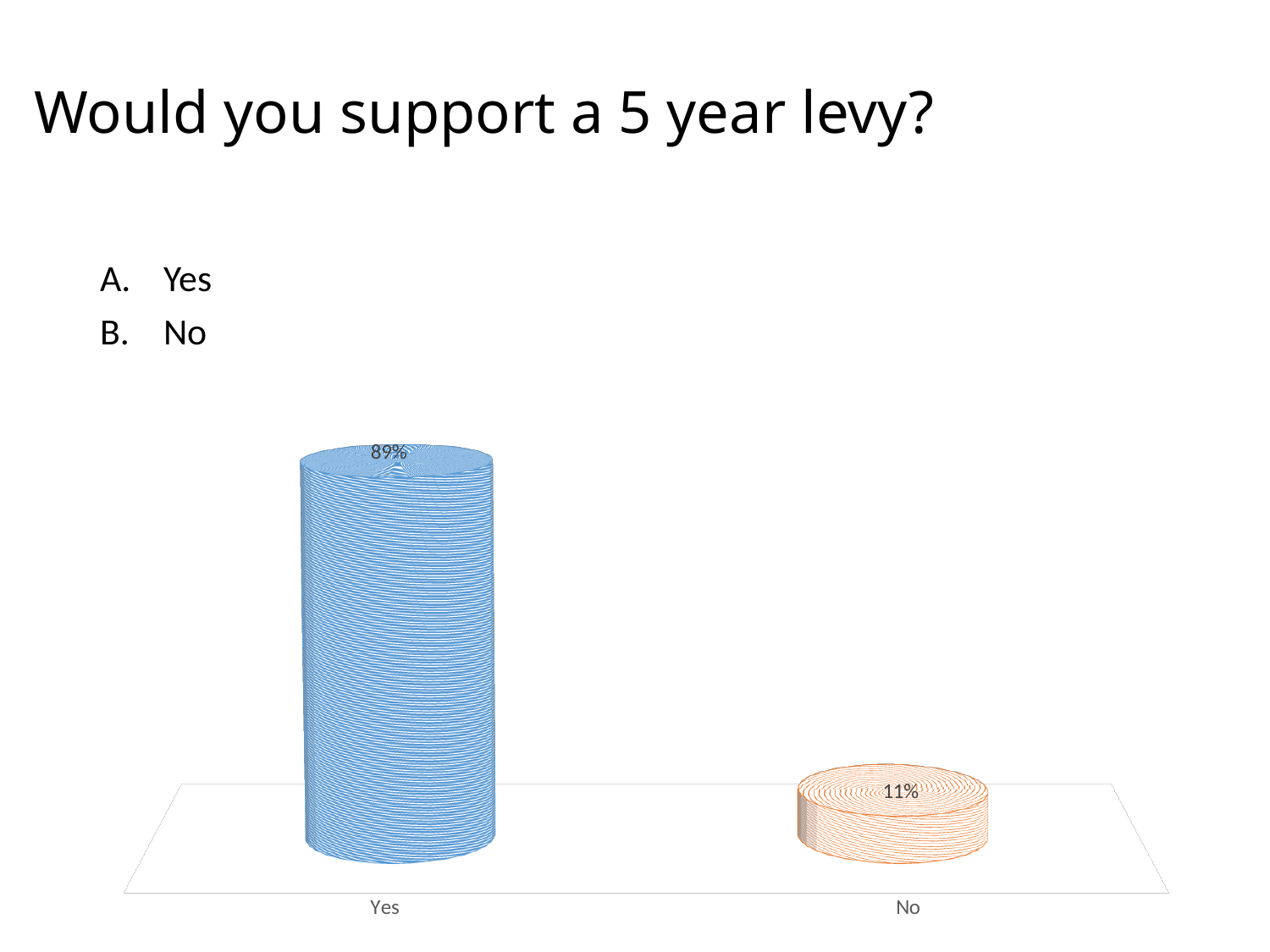
Which category has the lowest value? No Which is larger, the value for Yes or the value for No? Yes How many categories are shown on the x axis? 2 Which category has the highest value? Yes What colour is the bar for Yes? blue What is the difference between the values for Yes and No? 78% What kind of chart is shown on the slide? bar chart What is the value for Yes? 89% What is the total of the values for Yes and No? 100% What is the value for No? 11% What question is the chart on the slide about? Would you support a 5 year levy?